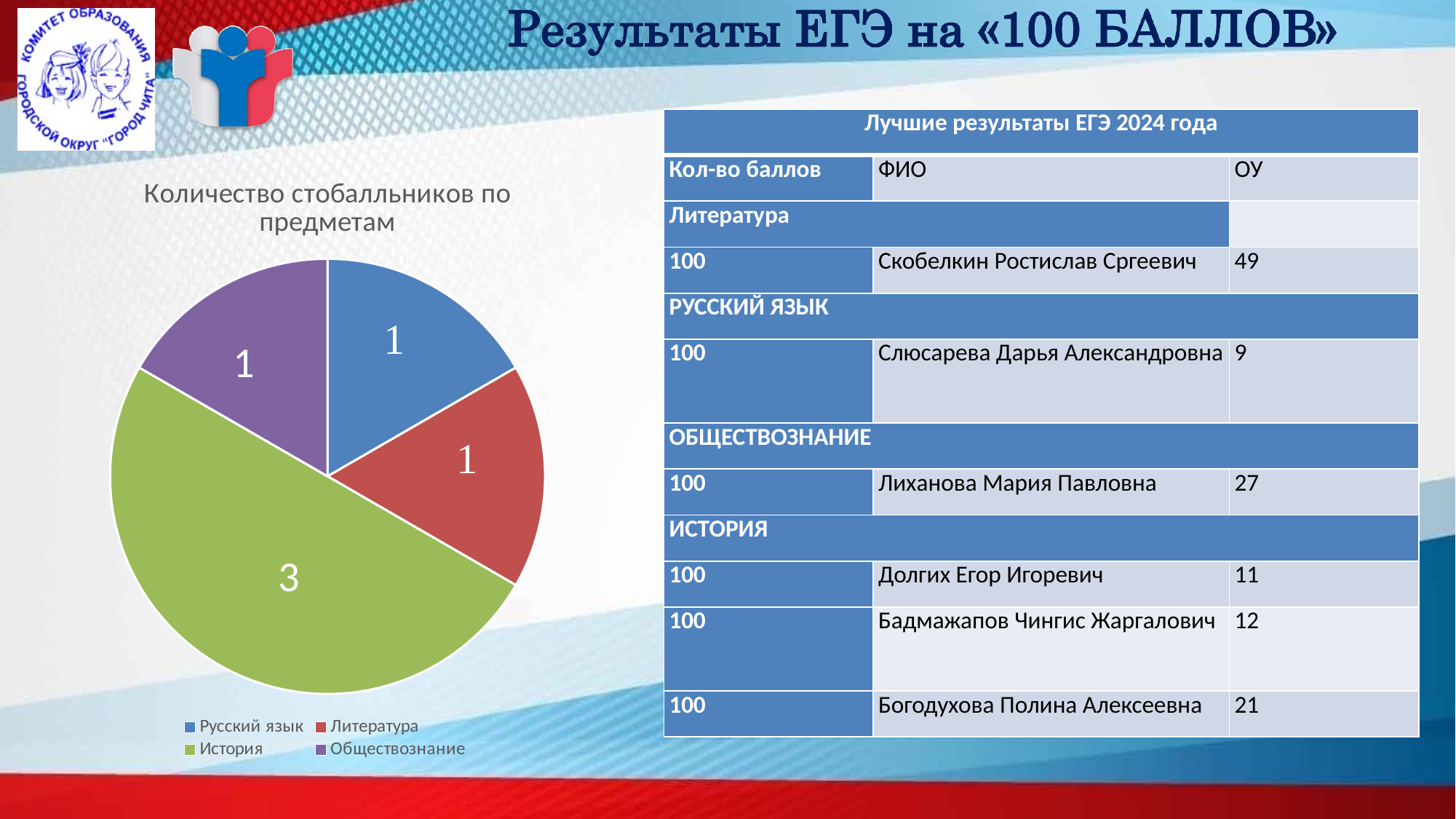
Which is larger, the value for История or the value for Русский язык? История How many entries does the chart legend list? 4 What is the value for История in the pie chart? 3 What is the value for Русский язык in the pie chart? 1 How many slices does the pie chart have? 4 Which subject has the largest slice in the pie chart? История What is the title of the chart? Количество стобалльников по предметам What is the total of all slices in the pie chart? 6 What is the value for Обществознание in the pie chart? 1 What share of the pie does История represent? 50% What kind of chart is shown on the slide? pie chart What is the difference between the values for История and Литература? 2